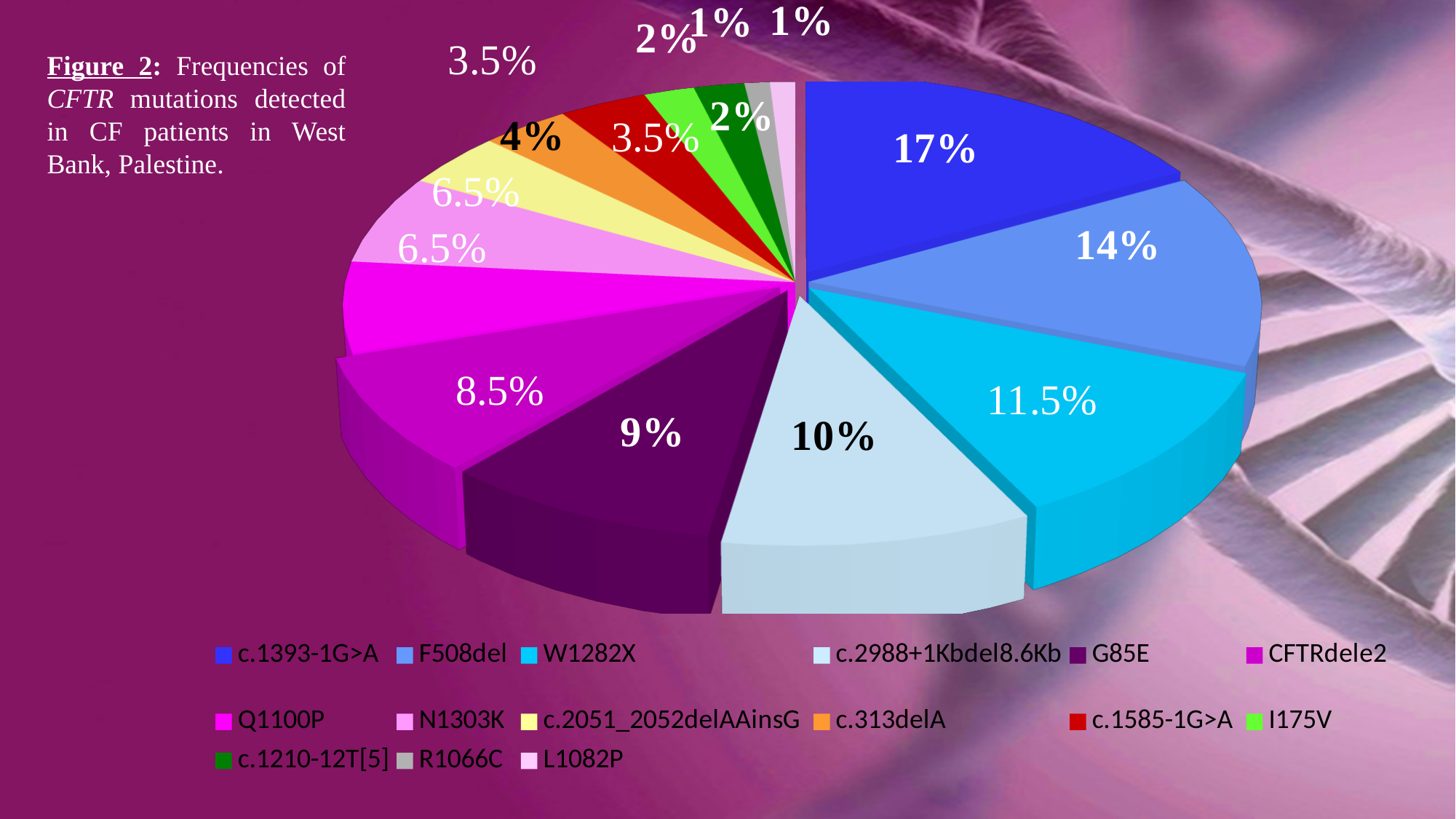
Which mutation has the largest slice of the pie? c.1393-1G>A How many mutations are listed in the legend? 15 What type of chart is shown on the slide? pie chart According to the figure caption, in which region were the CF patients located? West Bank, Palestine Which has a larger share, W1282X or G85E? W1282X What is the difference in percentage points between c.1393-1G>A and F508del? 3% What percentage is shown for G85E? 9% What percentage is shown for the c.1393-1G>A mutation? 17% What percentage is shown for W1282X? 11.5% What is the difference in percentage points between c.2988+1Kbdel8.6Kb and CFTRdele2? 1.5% What percentage is shown for F508del? 14% What percentage is shown for c.2988+1Kbdel8.6Kb? 10%